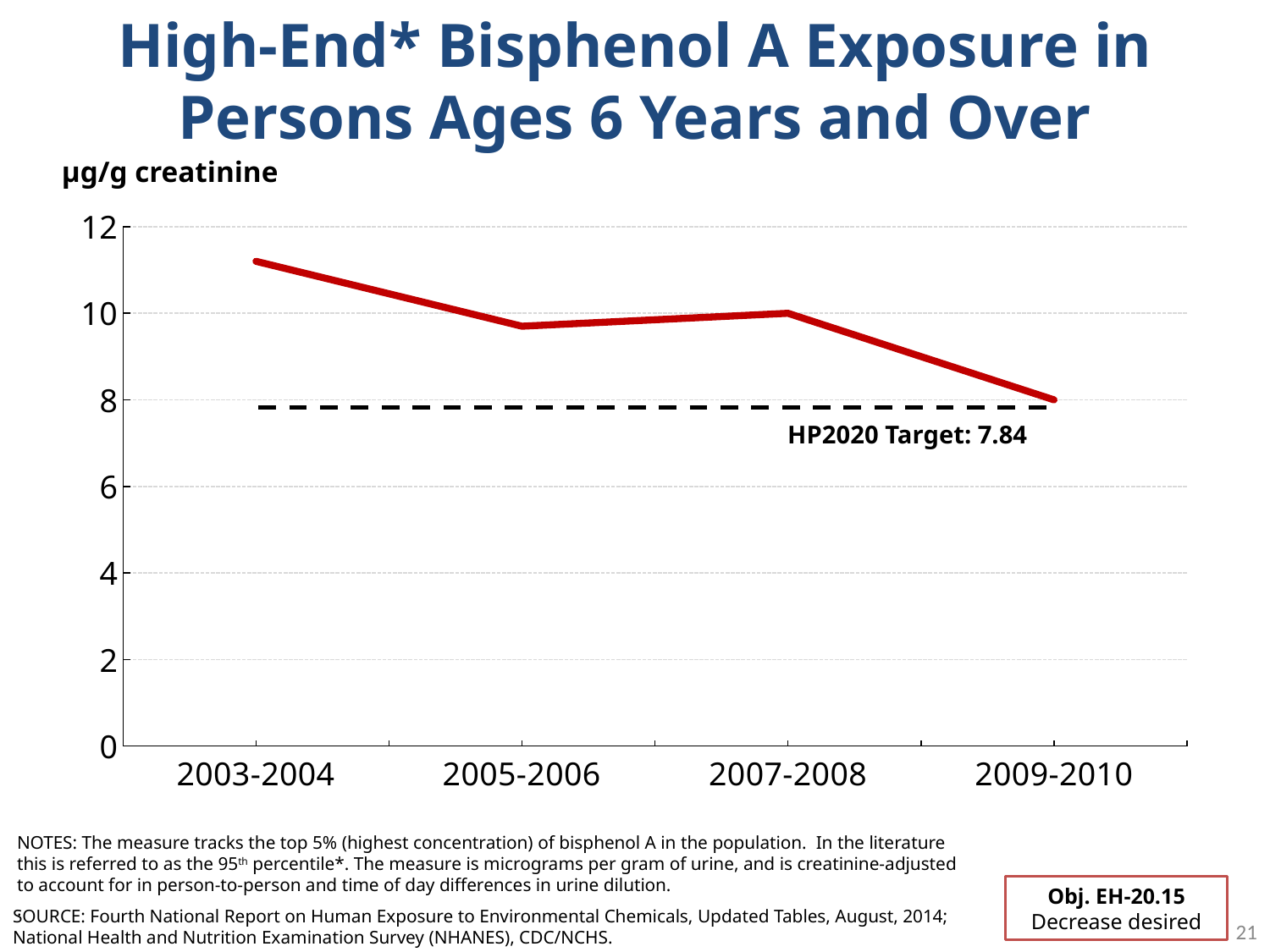
Overall, do the values rise or fall from 2003-2004 to 2009-2010? fall Is the value for 2009-2010 greater or less than 10? less What is the HP2020 Target value shown by the dashed line? 7.84 How many survey periods are plotted on the x axis? 4 Which survey period has the lowest bisphenol A exposure value? 2009-2010 Which is larger, the value for 2003-2004 or the value for 2005-2006? 2003-2004 Is the value for 2005-2006 greater or less than 10? less Which is larger, the value for 2007-2008 or the value for 2009-2010? 2007-2008 Which survey period has the highest bisphenol A exposure value? 2003-2004 Is the value for 2003-2004 greater or less than 10? greater What unit is the y axis measured in? µg/g creatinine What kind of chart is shown on the slide? line chart